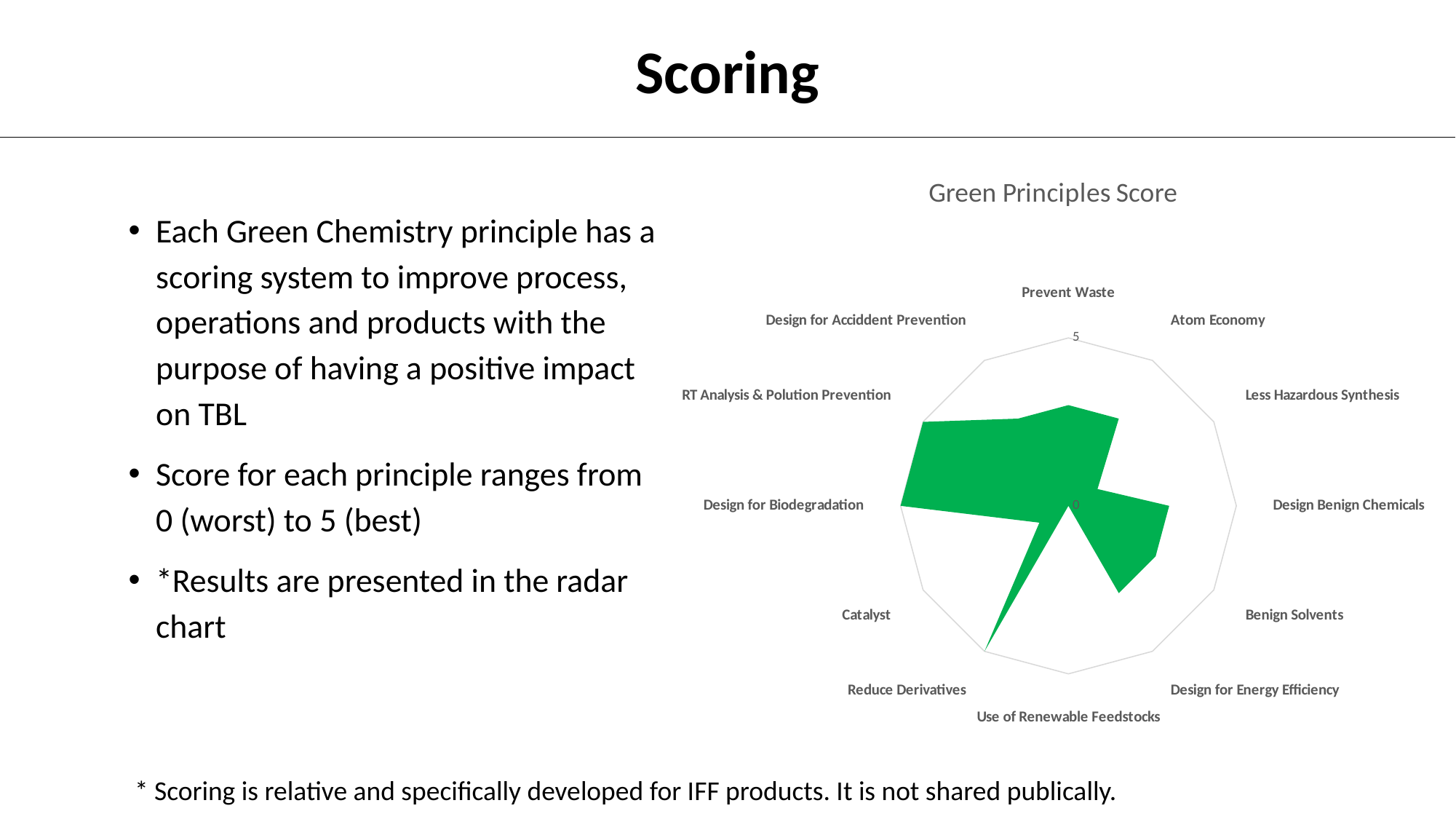
Which has the larger score, Prevent Waste or Less Hazardous Synthesis? Prevent Waste How many principles (categories) are plotted on the radar chart? 12 Which has the larger score, RT Analysis & Polution Prevention or Catalyst? RT Analysis & Polution Prevention What is the maximum value shown on the radar chart's axis? 5 Which has the larger score, Design Benign Chemicals or Use of Renewable Feedstocks? Design Benign Chemicals What is the title of the chart? Green Principles Score What kind of chart is shown on the slide? Radar chart